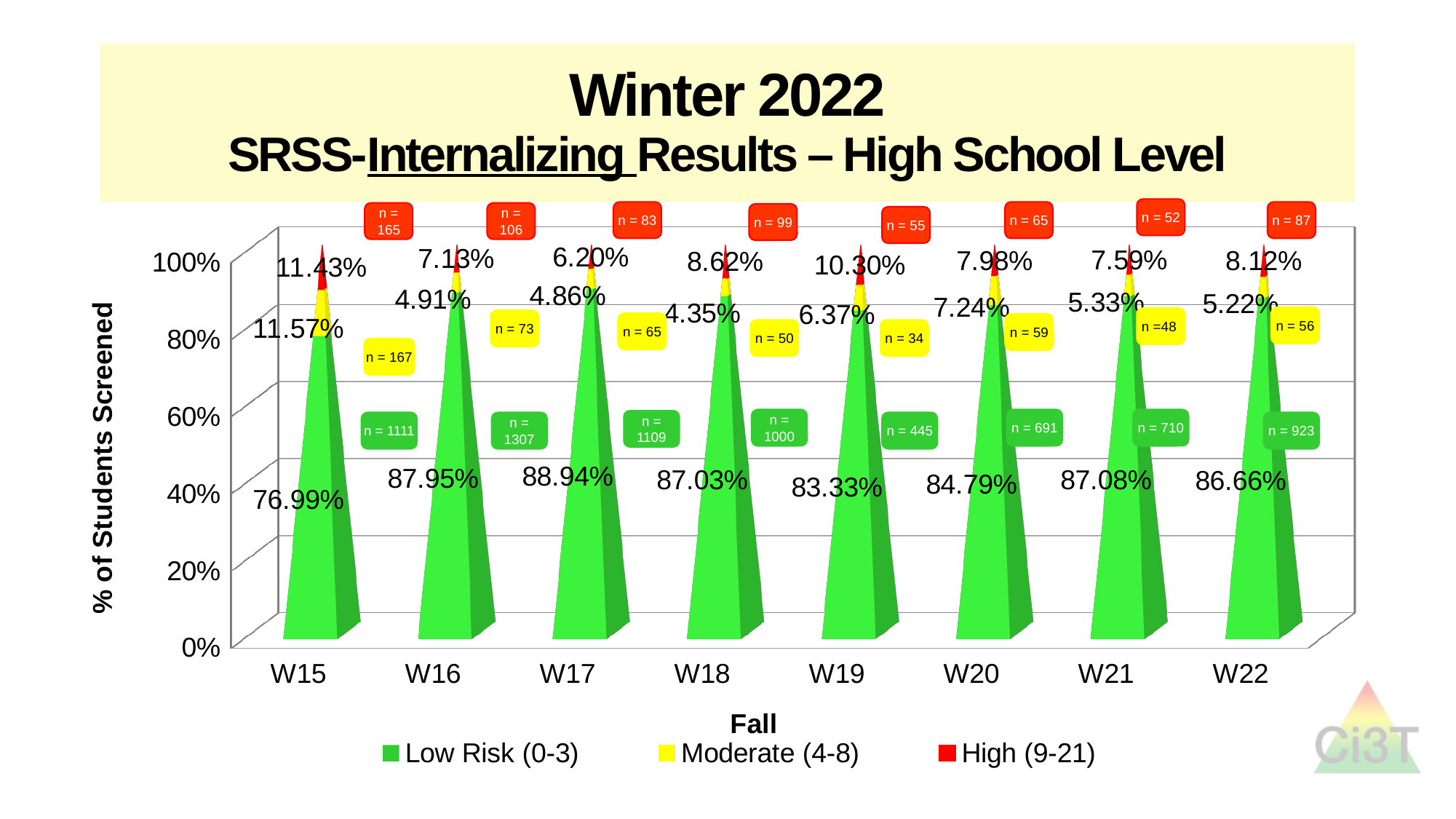
What kind of chart is shown on the slide? Stacked bar chart Which category has the lowest Low Risk (0-3) percentage? W15 Which has a larger High (9-21) percentage, W19 or W20? W19 Which category has the highest Low Risk (0-3) percentage? W17 How many series does the legend list? 3 What is the difference in Low Risk (0-3) percentage between W17 and W15? 11.95% What is the title of the y axis? % of Students Screened What is the Moderate (4-8) percentage for W20? 7.24% What is the High (9-21) percentage for W19? 10.30% Which category has the highest High (9-21) percentage? W15 How many categories are shown on the x axis? 8 What is the Low Risk (0-3) percentage for W15? 76.99%